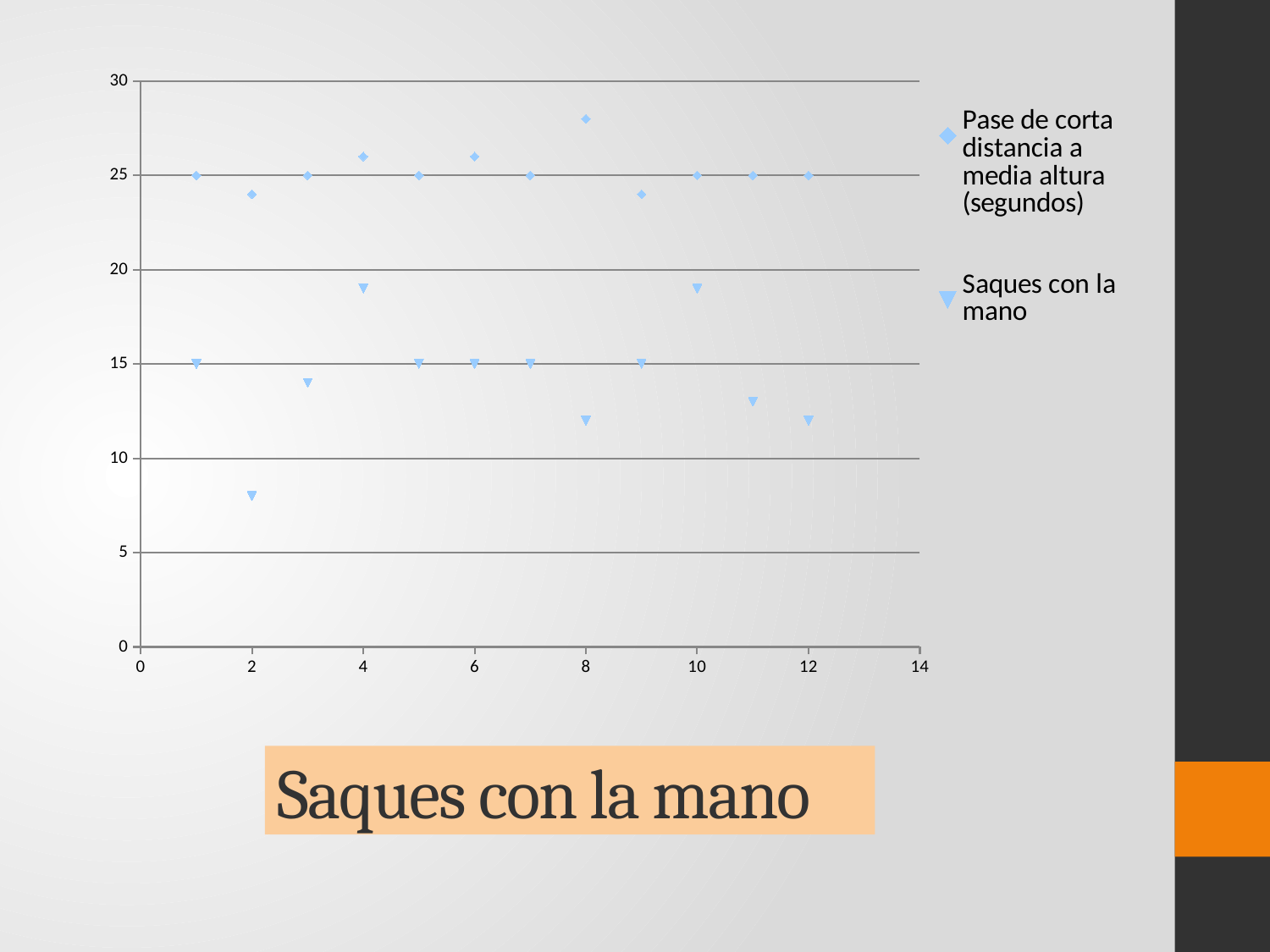
At x = 8, which series has the higher value? Pase de corta distancia a media altura (segundos) What is the value of the 'Pase de corta distancia a media altura (segundos)' series at x = 1? 25 What kind of chart is shown on the slide? Scatter chart What is the value of the 'Saques con la mano' series at x = 5? 15 At which x value does the 'Pase de corta distancia a media altura (segundos)' series reach its highest point? 8 Is the value of the 'Saques con la mano' series at x = 2 greater or less than 10? less At which x value does the 'Saques con la mano' series reach its lowest point? 2 Is the value of the 'Saques con la mano' series at x = 4 greater or less than 15? greater What is the title shown below the chart? Saques con la mano How many series does the legend list? 2 Is the value of the 'Pase de corta distancia a media altura (segundos)' series at x = 8 greater or less than 25? greater How many data points are plotted for the 'Saques con la mano' series? 12